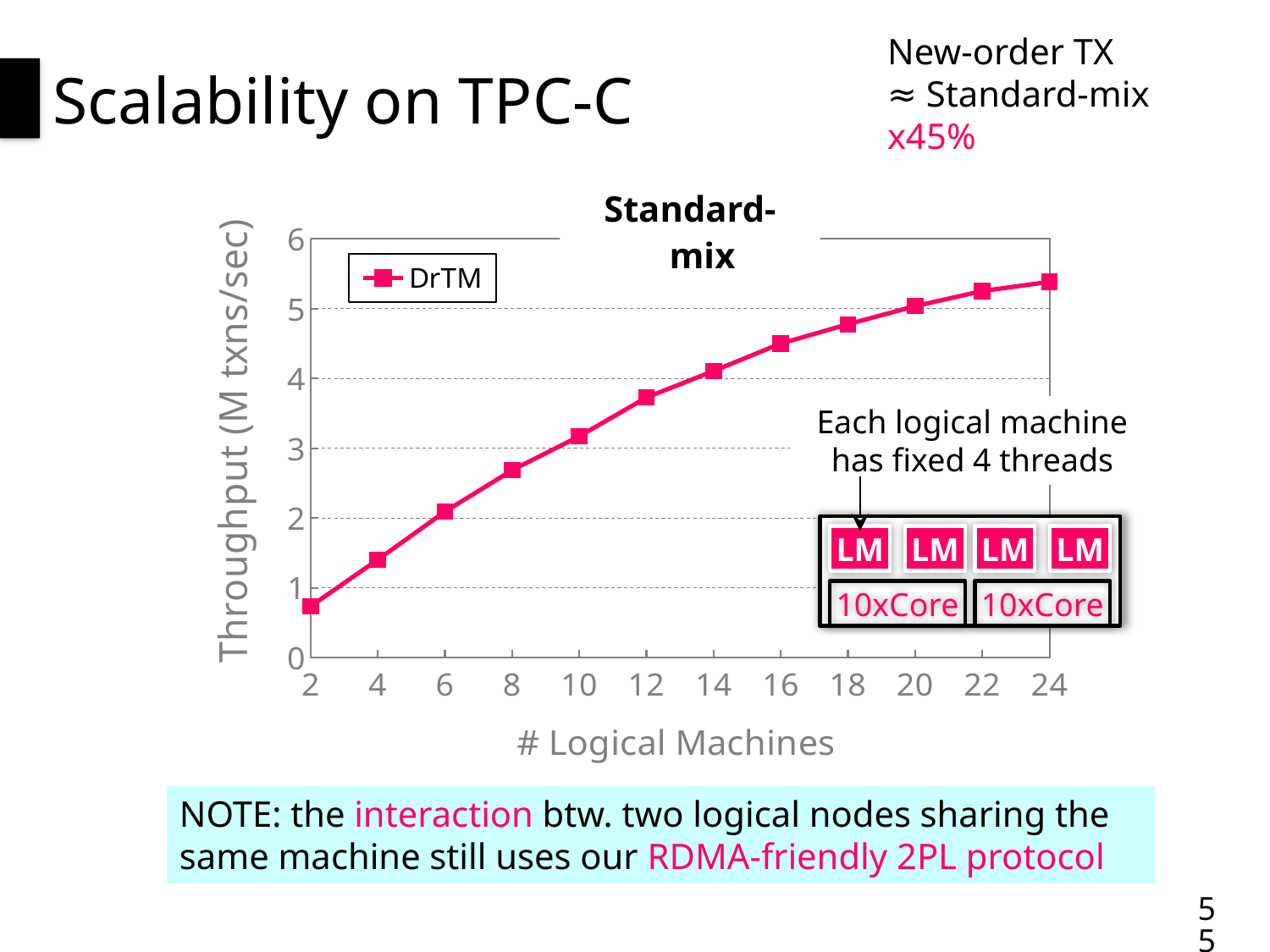
What kind of chart is shown on the slide? line chart How many data points are plotted on the DrTM line? 12 What is the title of the chart? Standard-mix Is the throughput for 10 logical machines greater or less than 3 M txns/sec? greater Is the throughput for 24 logical machines greater or less than 5 M txns/sec? greater How many series does the legend list? 1 Is the throughput for 2 logical machines greater or less than 1 M txns/sec? less Does the throughput rise or fall as the number of logical machines increases? rise What is the name of the series shown in the legend? DrTM At which number of logical machines is the throughput lowest? 2 At which number of logical machines is the throughput highest? 24